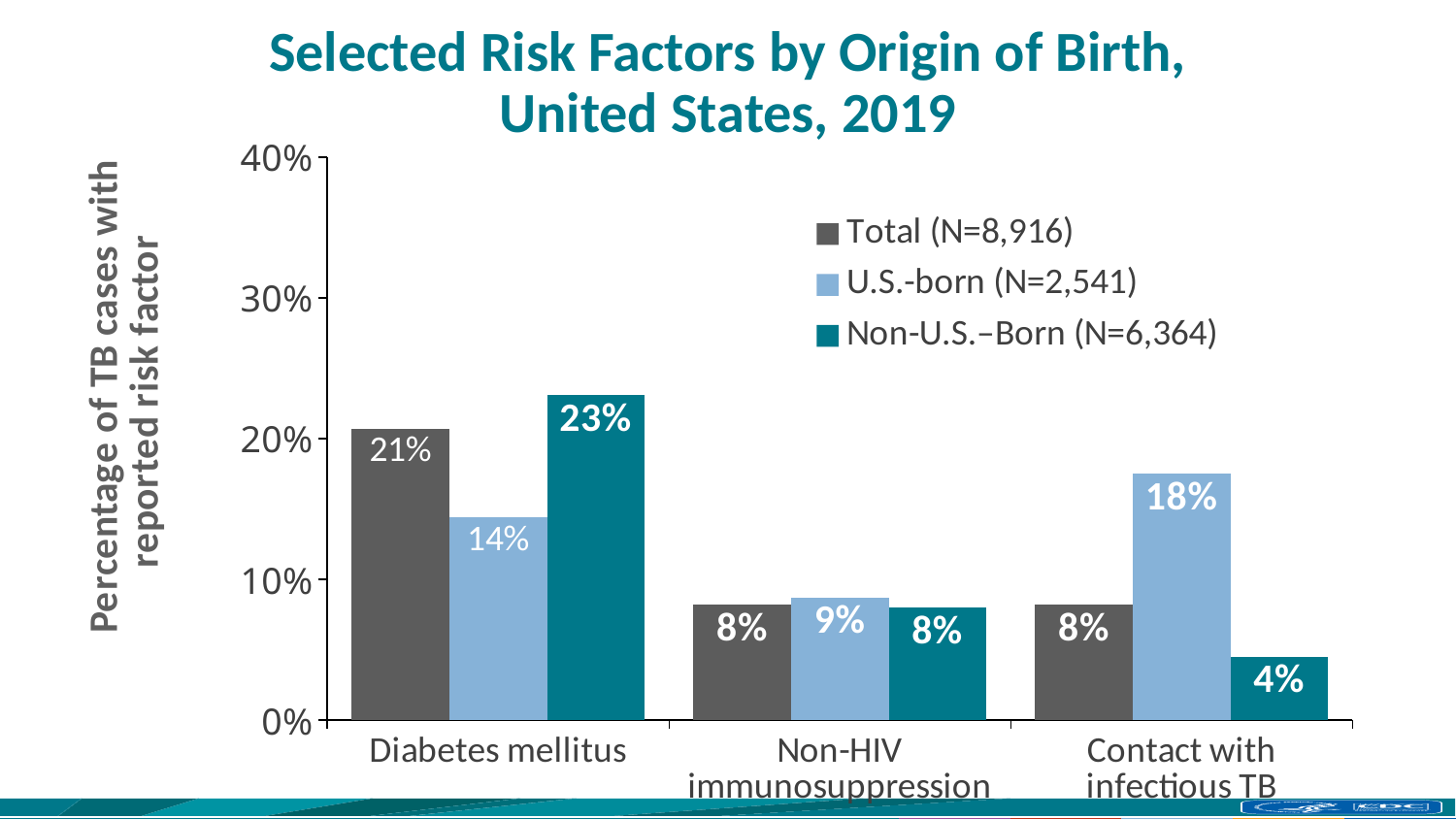
What is the difference between the U.S.-born and Non-U.S.–Born values for Contact with infectious TB? 14% Which risk factor has the highest Total value? Diabetes mellitus What is the value for U.S.-born for Contact with infectious TB? 18% What kind of chart is shown on the slide? Bar chart How many series does the legend list? 3 What is the value for Non-U.S.–Born for Diabetes mellitus? 23% What is the difference between the Non-U.S.–Born and U.S.-born values for Diabetes mellitus? 9% How many risk factor categories are shown on the x axis? 3 Which risk factor has the lowest Non-U.S.–Born value? Contact with infectious TB For Contact with infectious TB, which is larger: the U.S.-born value or the Non-U.S.–Born value? U.S.-born Is the Total value for Diabetes mellitus greater or less than 20%? greater What is the Total value for Non-HIV immunosuppression? 8%